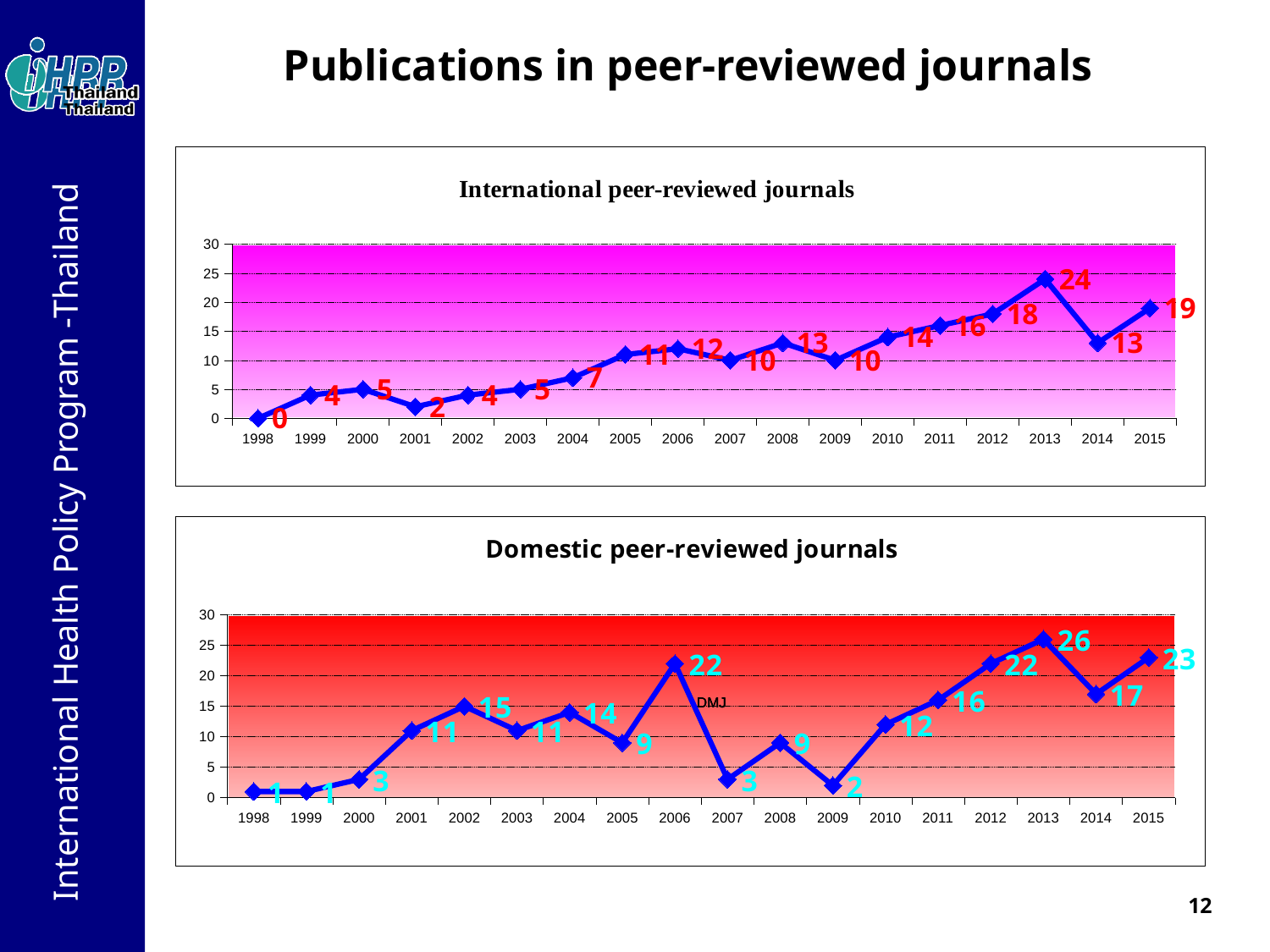
In the International peer-reviewed journals chart, what is the difference between the values for 2013 and 2014? 11 In the Domestic peer-reviewed journals chart, what is the difference between the values for 2015 and 2014? 6 In the Domestic peer-reviewed journals chart, which is larger, the value for 2012 or the value for 2011? 2012 What is the title of the top chart on the slide? International peer-reviewed journals In the International peer-reviewed journals chart, which year has the highest value? 2013 In the Domestic peer-reviewed journals chart, what is the value for 2006? 22 In the International peer-reviewed journals chart, do the values generally rise or fall from 1998 to 2013? Rise What type of chart is the Domestic peer-reviewed journals chart? Line chart In the Domestic peer-reviewed journals chart, which year has the highest value? 2013 In the International peer-reviewed journals chart, what is the value for 2013? 24 In the International peer-reviewed journals chart, which year has the lowest value? 1998 In the International peer-reviewed journals chart, how many years are plotted on the x axis? 18